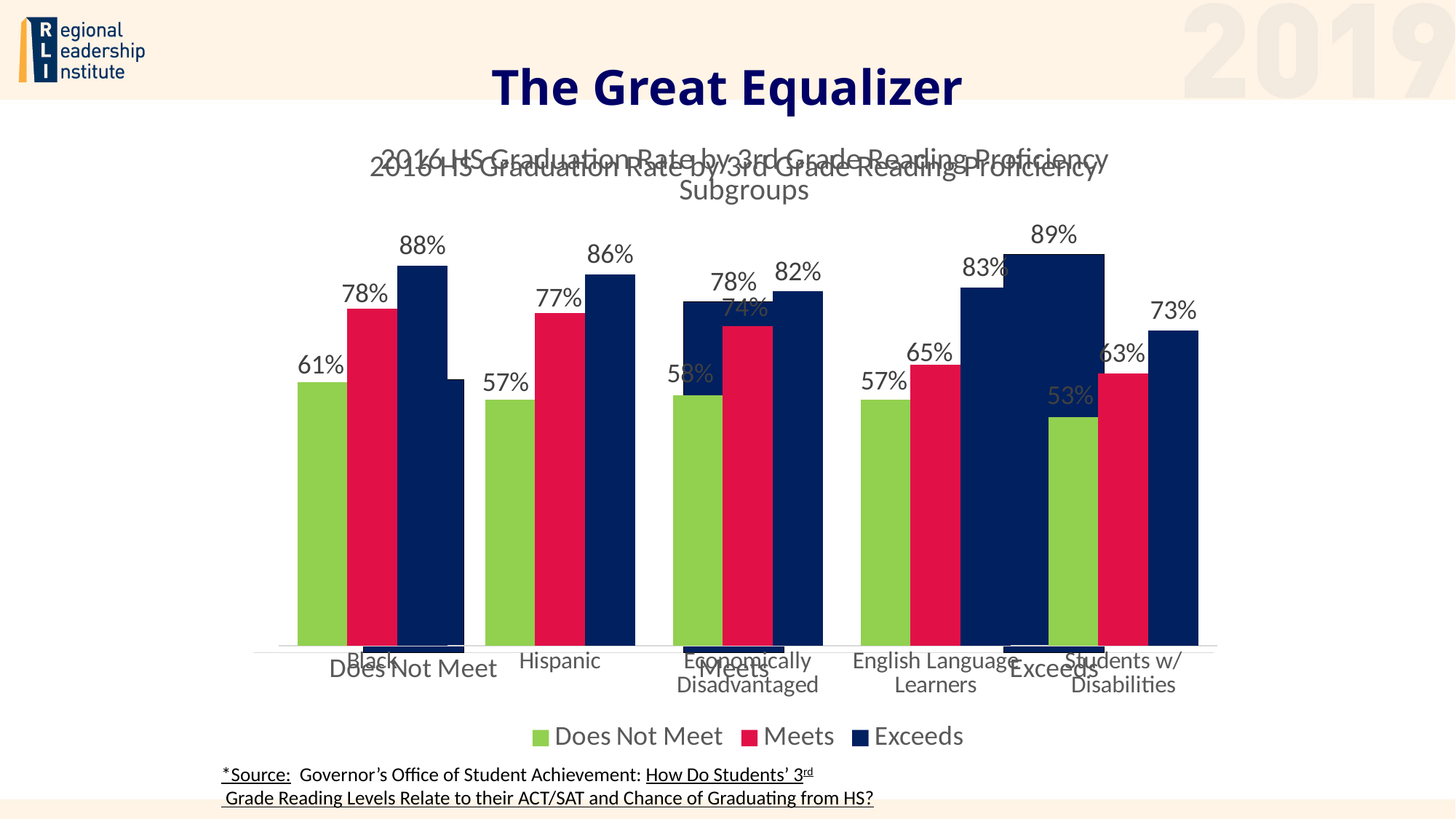
In the Subgroups chart, what is the difference between the Exceeds and Does Not Meet values for Black students? 27% How many series does the legend of the Subgroups chart list? 3 In the Subgroups chart, which is larger: the Meets value for Black students or the Meets value for Economically Disadvantaged students? Black What type of chart is the Subgroups chart? Bar chart In the Subgroups chart, what is the difference between the Meets values for Hispanic students and Students w/ Disabilities? 14% In the Subgroups chart, what is the Meets value for English Language Learners? 65% In the Subgroups chart, what is the Exceeds value for Students w/ Disabilities? 73% In the Subgroups chart, which subgroup has the highest Exceeds value? Black In the Subgroups chart, what is the Does Not Meet value for Hispanic students? 57% How many subgroups are shown on the x axis of the Subgroups chart? 5 In the Subgroups chart, which subgroup has the lowest Does Not Meet value? Students w/ Disabilities In the '2016 HS Graduation Rate by 3rd Grade Reading Proficiency Subgroups' chart, what is the Exceeds value for Black students? 88%